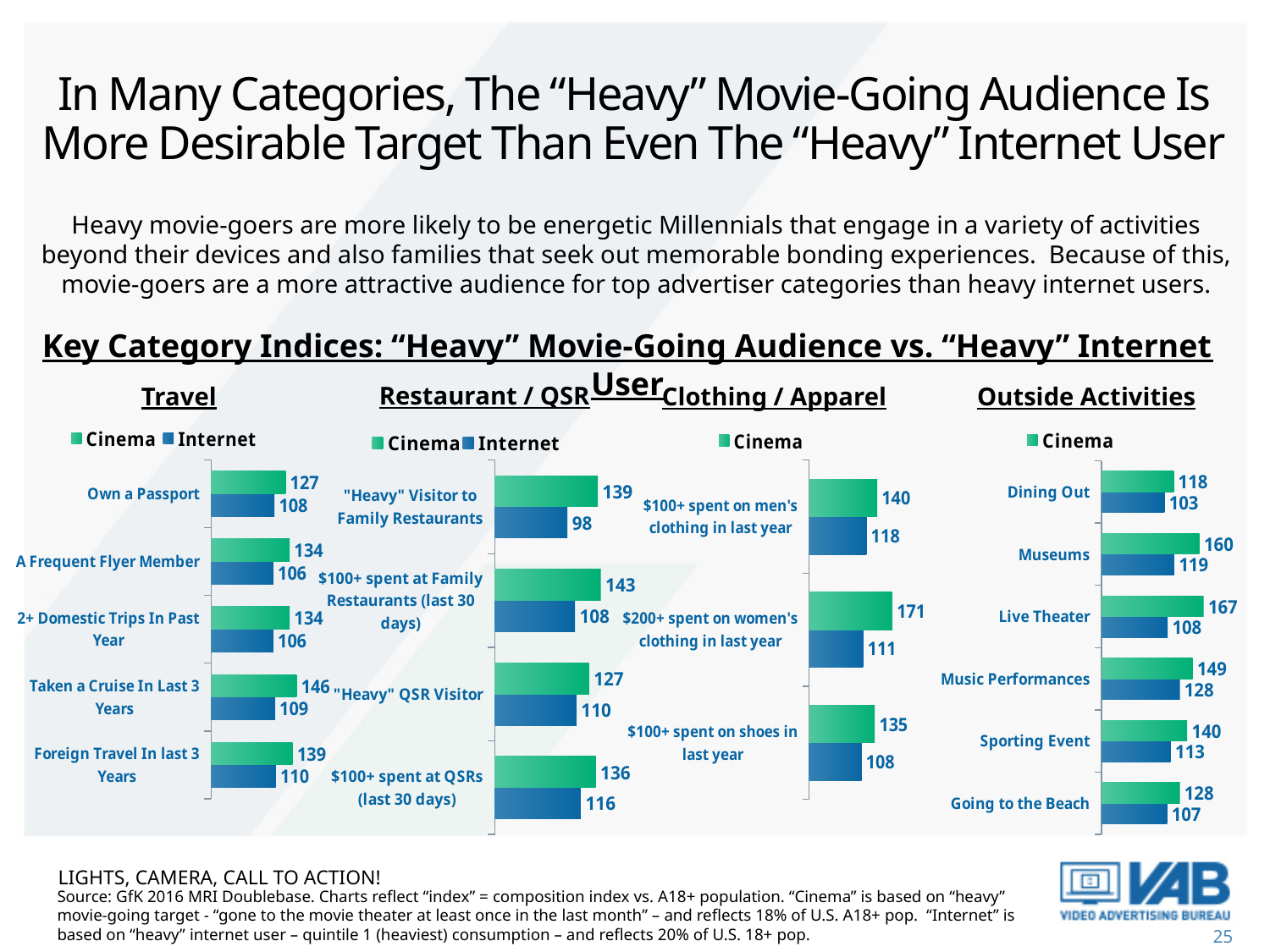
In the Travel chart, what is the Cinema index for Taken a Cruise In Last 3 Years? 146 In the Travel chart, what is the difference between the Cinema and Internet indices for Foreign Travel In last 3 Years? 29 In the Restaurant / QSR chart, which category has the lowest Cinema index? "Heavy" QSR Visitor What type of chart is the Outside Activities chart? Bar chart In the Outside Activities chart, which category has the highest Cinema index? Live Theater In the Clothing / Apparel chart, what is the Cinema index for $200+ spent on women's clothing in last year? 171 In the Restaurant / QSR chart, what is the Internet index for "Heavy" Visitor to Family Restaurants? 98 In the Clothing / Apparel chart, which is larger: the Cinema index for $100+ spent on men's clothing or the Cinema index for $100+ spent on shoes? $100+ spent on men's clothing How many series does the legend of the Travel chart list? 2 In the Restaurant / QSR chart, how many categories are shown? 4 In the Travel chart, which category has the highest Cinema index? Taken a Cruise In Last 3 Years In the Outside Activities chart, what is the Internet index for Music Performances? 128